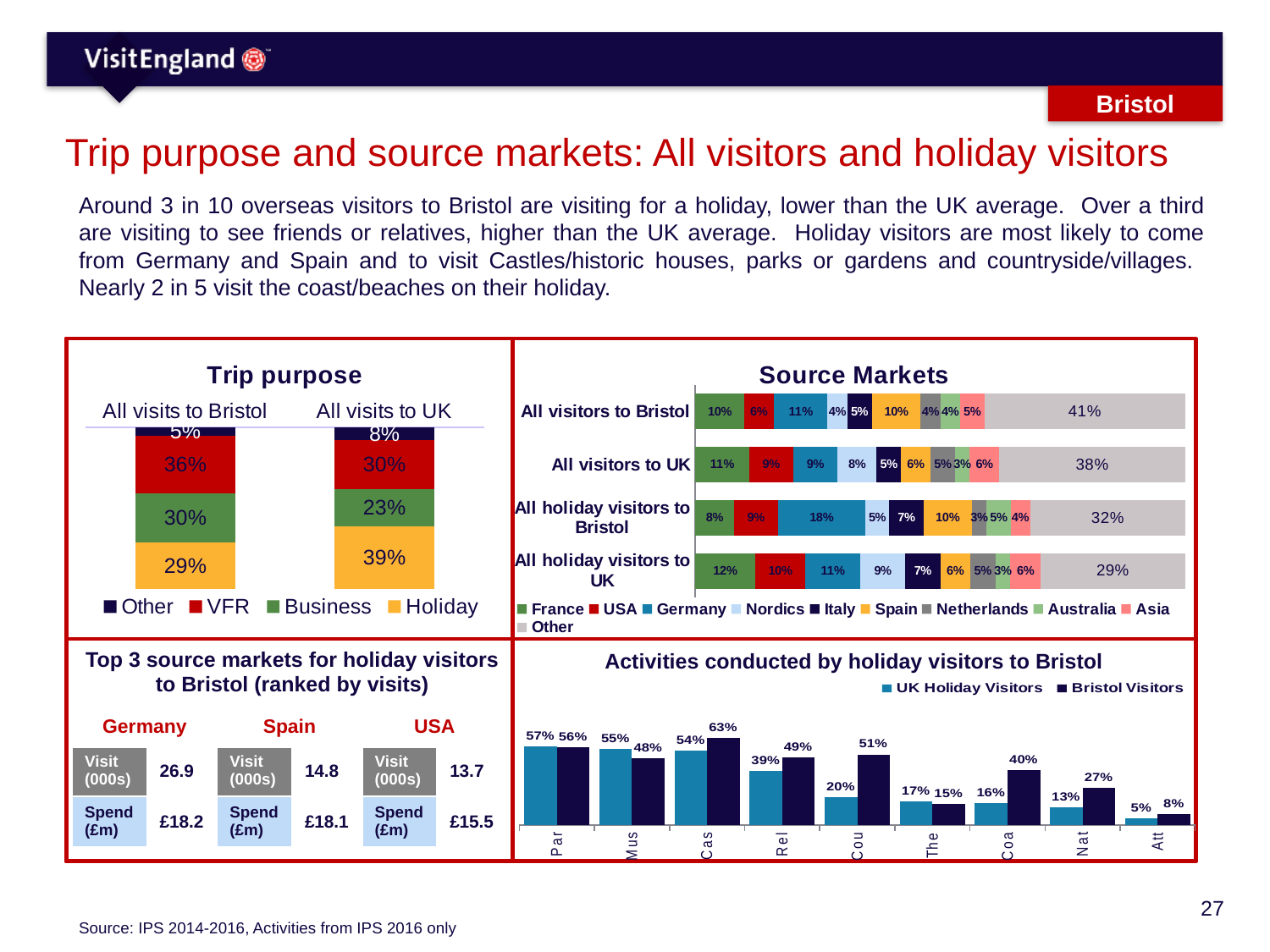
In the Source Markets chart, how many source markets does the legend list? 10 In the Activities conducted by holiday visitors to Bristol chart, what is the Bristol Visitors value for 'Cas'? 63% In the Trip purpose chart, what is the difference between the Business share for all visits to Bristol and for all visits to the UK? 7 percentage points What type of chart is the Activities conducted by holiday visitors to Bristol chart? Bar chart In the Activities conducted by holiday visitors to Bristol chart, which is larger for 'Cou': UK Holiday Visitors or Bristol Visitors? Bristol Visitors In the Source Markets chart, what share of all holiday visitors to Bristol come from Germany? 18% In the Trip purpose chart, what percentage of all visits to Bristol are VFR? 36% In the Source Markets chart, how many bars (visitor groups) are shown? 4 In the Source Markets chart, what share of all visitors to Bristol come from Germany? 11% In the Trip purpose chart, what percentage of all visits to the UK are Holiday? 39% In the Trip purpose chart, how many series does the legend list? 4 In the Source Markets chart, what is the 'Other' share for all holiday visitors to the UK? 29%